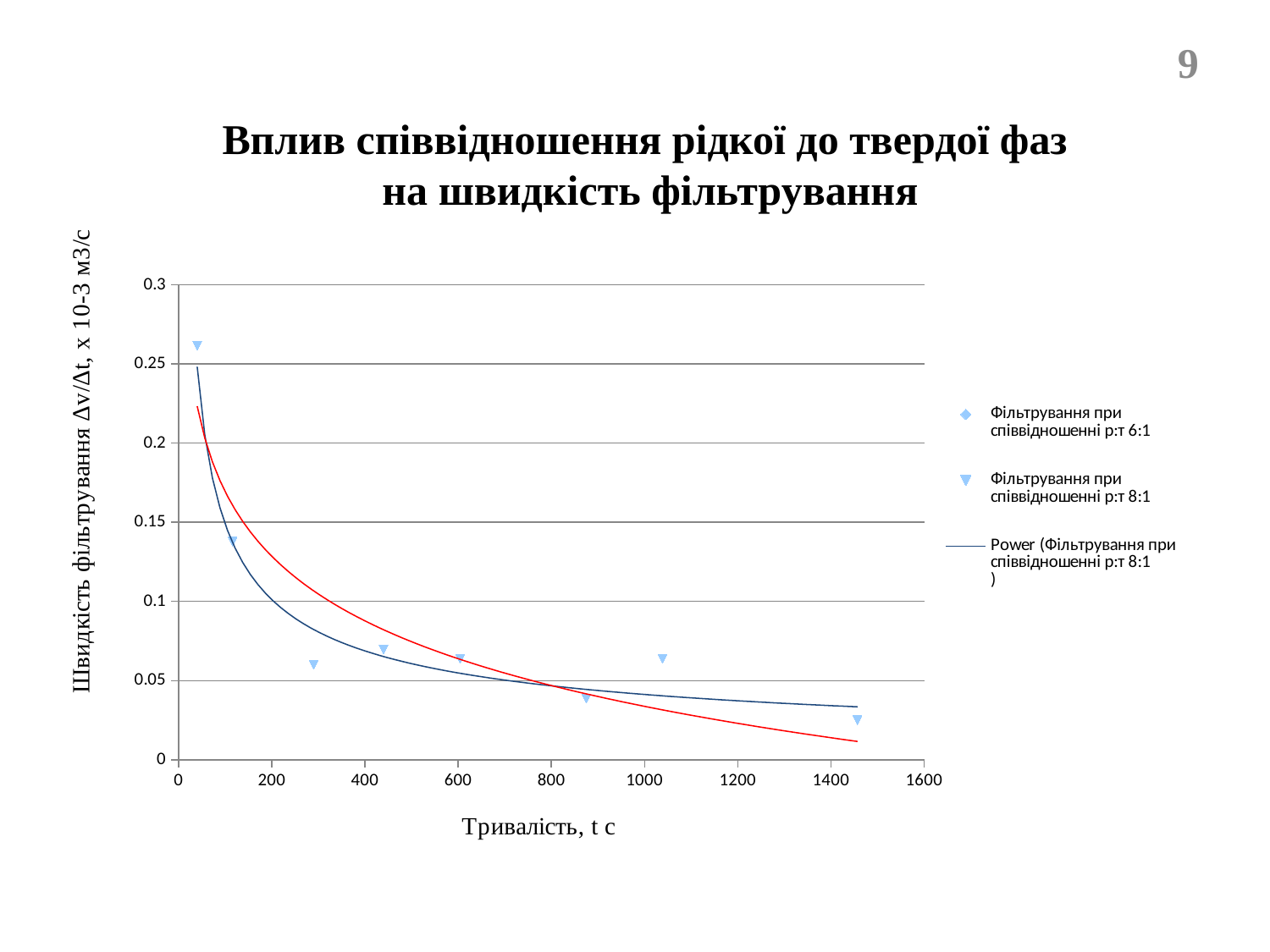
Do the plotted filtration speed values rise or fall as duration increases along the x axis? fall Which of the two plotted points is larger: the one near t = 100 or the one near t = 900? the one near t = 100 How many entries does the chart legend list? 3 What is the title of the x axis? Тривалість, t с What is the maximum value shown on the y axis? 0.3 How many data points are plotted for the series 'Фільтрування при співвідношенні р:т 8:1'? 8 Is the value of the plotted point near t = 300 greater or less than 0.1? less Is the value of the first plotted point (near t = 0) greater or less than 0.25? greater What kind of chart is shown on the slide? scatter chart Is the value of the last plotted point (near t = 1400–1600) greater or less than 0.05? less